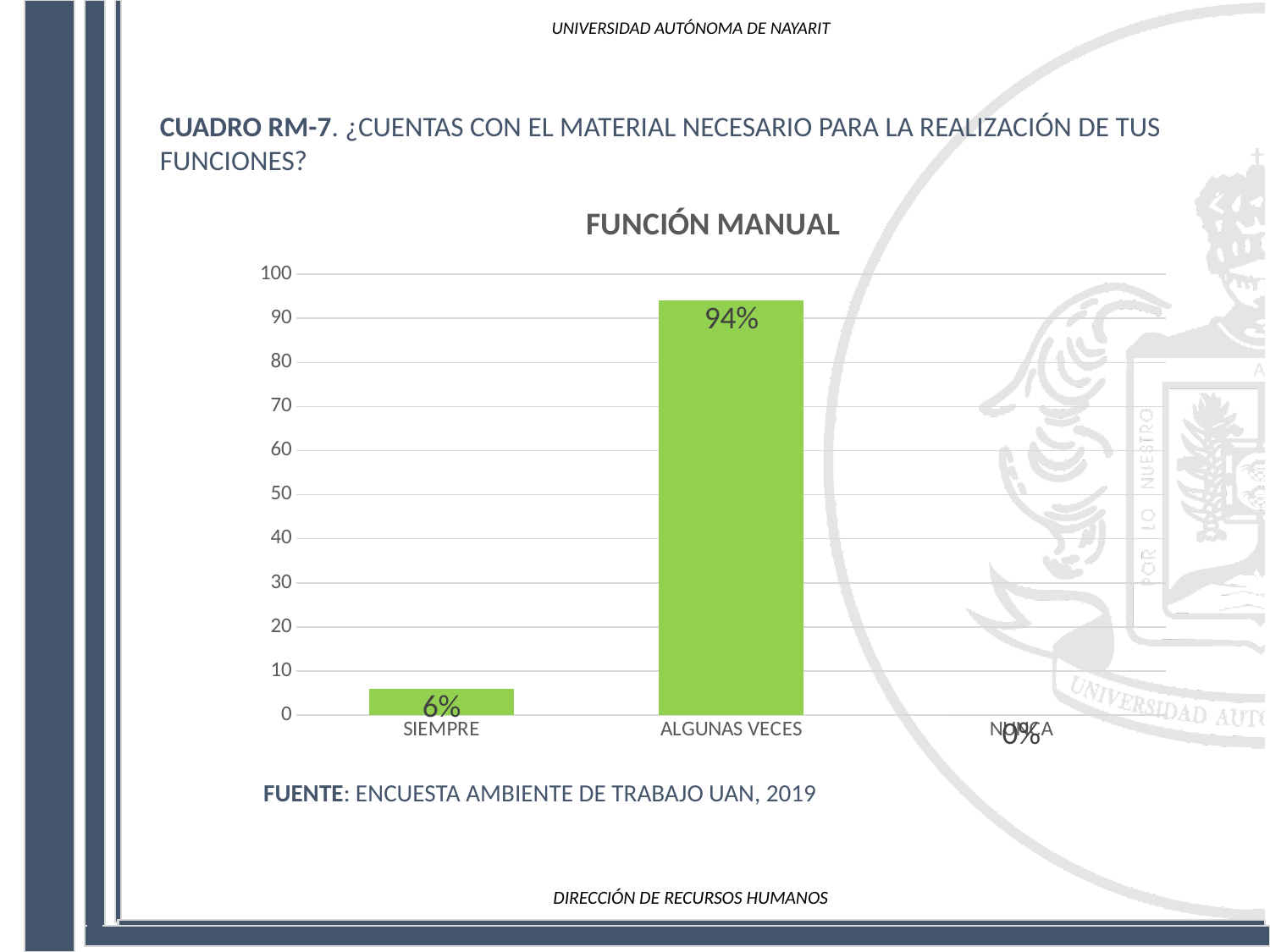
How many categories are shown on the x axis? 3 Is the value for SIEMPRE greater or less than 10? less What is the value for NUNCA? 0% What is the title of the chart? FUNCIÓN MANUAL What kind of chart is shown on the slide? bar chart Is the value for ALGUNAS VECES greater or less than 50? greater What is the difference between the values for ALGUNAS VECES and SIEMPRE? 88% Which is larger, the value for SIEMPRE or the value for ALGUNAS VECES? ALGUNAS VECES What is the value for SIEMPRE? 6% Which category has the highest value? ALGUNAS VECES What is the value for ALGUNAS VECES? 94% Which category has the lowest value? NUNCA